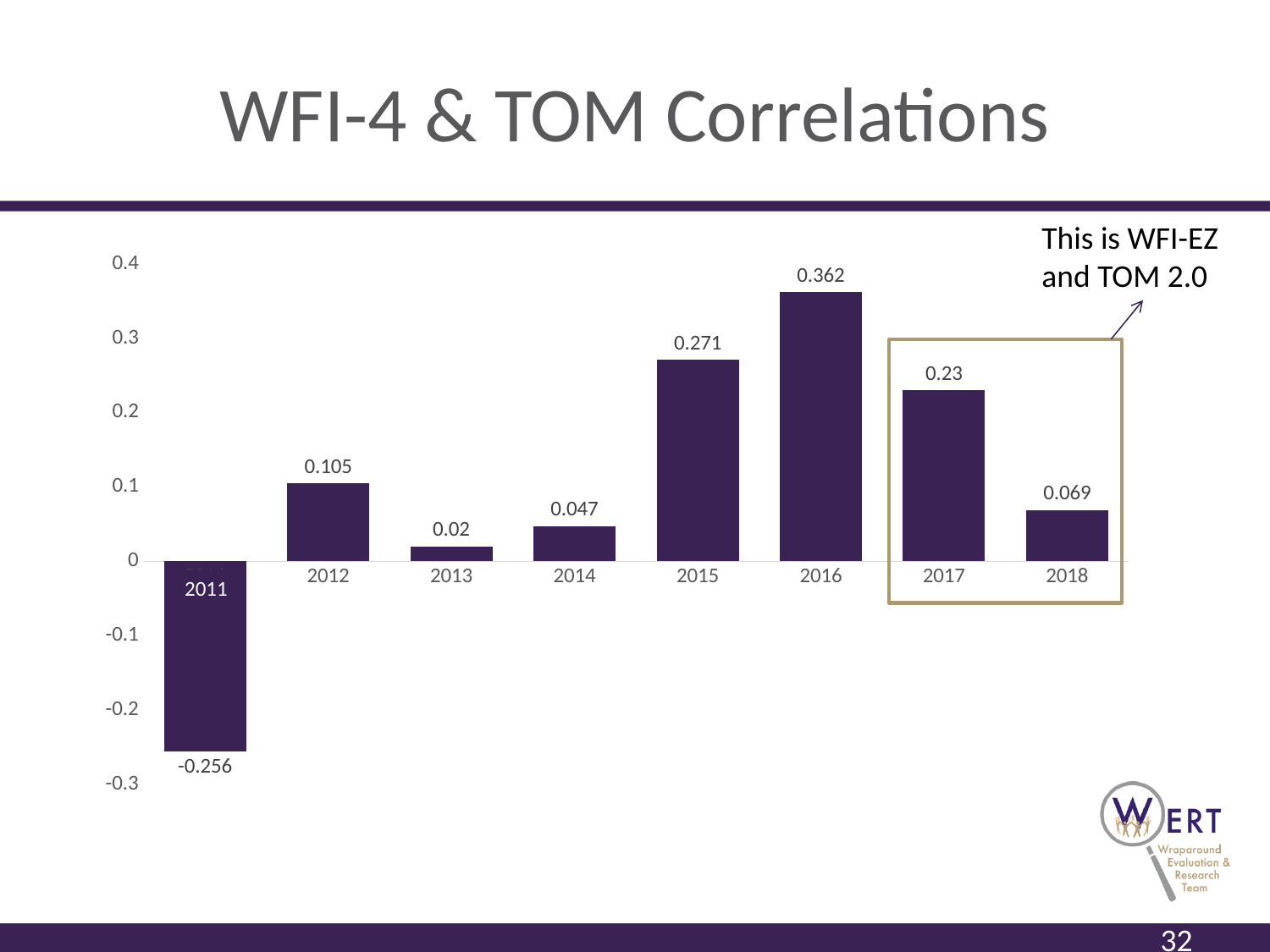
What is the difference between the values for 2016 and 2015? 0.091 How many years are shown on the x axis? 8 What is the correlation value for 2011? -0.256 What kind of chart is shown on the slide? bar chart Is the value for 2015 greater or less than 0.2? greater What is the correlation value for 2016? 0.362 Do the values rise or fall from 2016 to 2018? fall Which is larger, the value for 2017 or the value for 2018? 2017 Which year has the lowest correlation value? 2011 Which years are enclosed in the highlighted box labelled 'This is WFI-EZ and TOM 2.0'? 2017 and 2018 What is the correlation value for 2018? 0.069 Which year has the highest correlation value? 2016